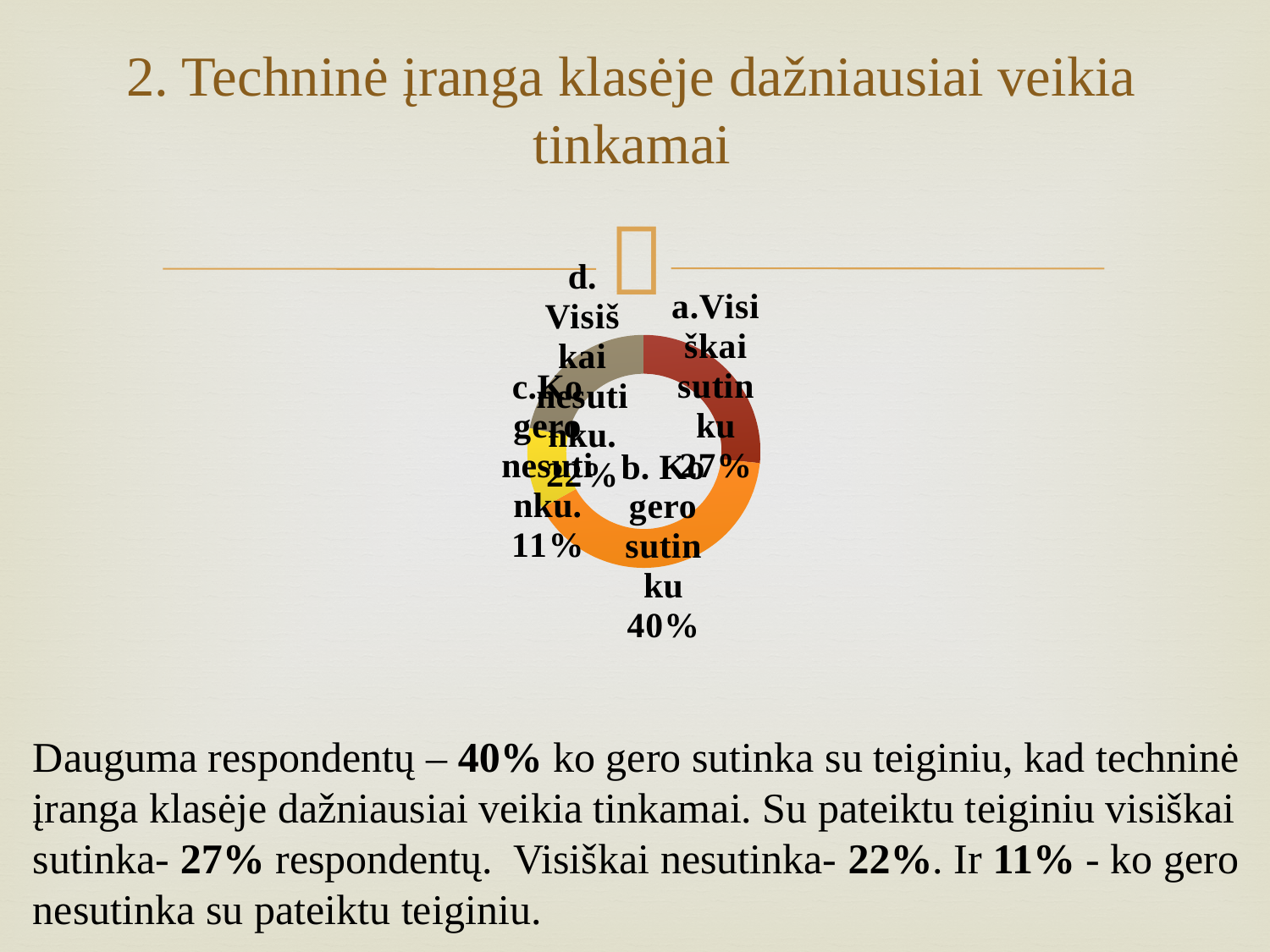
Which response category has the smallest share? c. Ko gero nesutinku What kind of chart is shown on the slide? Doughnut chart What percentage of respondents chose "d. Visiškai nesutinku"? 22% How many response categories are shown in the chart? 4 What is the difference in percentage points between "d. Visiškai nesutinku" and "c. Ko gero nesutinku"? 11 Which response category has the largest share? b. Ko gero sutinku What percentage of respondents chose "c. Ko gero nesutinku"? 11% What is the difference in percentage points between "b. Ko gero sutinku" and "a. Visiškai sutinku"? 13 Which is larger: the share for "a. Visiškai sutinku" or for "d. Visiškai nesutinku"? a. Visiškai sutinku What percentage of respondents chose "b. Ko gero sutinku"? 40% What colour is the slice for "b. Ko gero sutinku"? Orange What percentage of respondents chose "a. Visiškai sutinku"? 27%